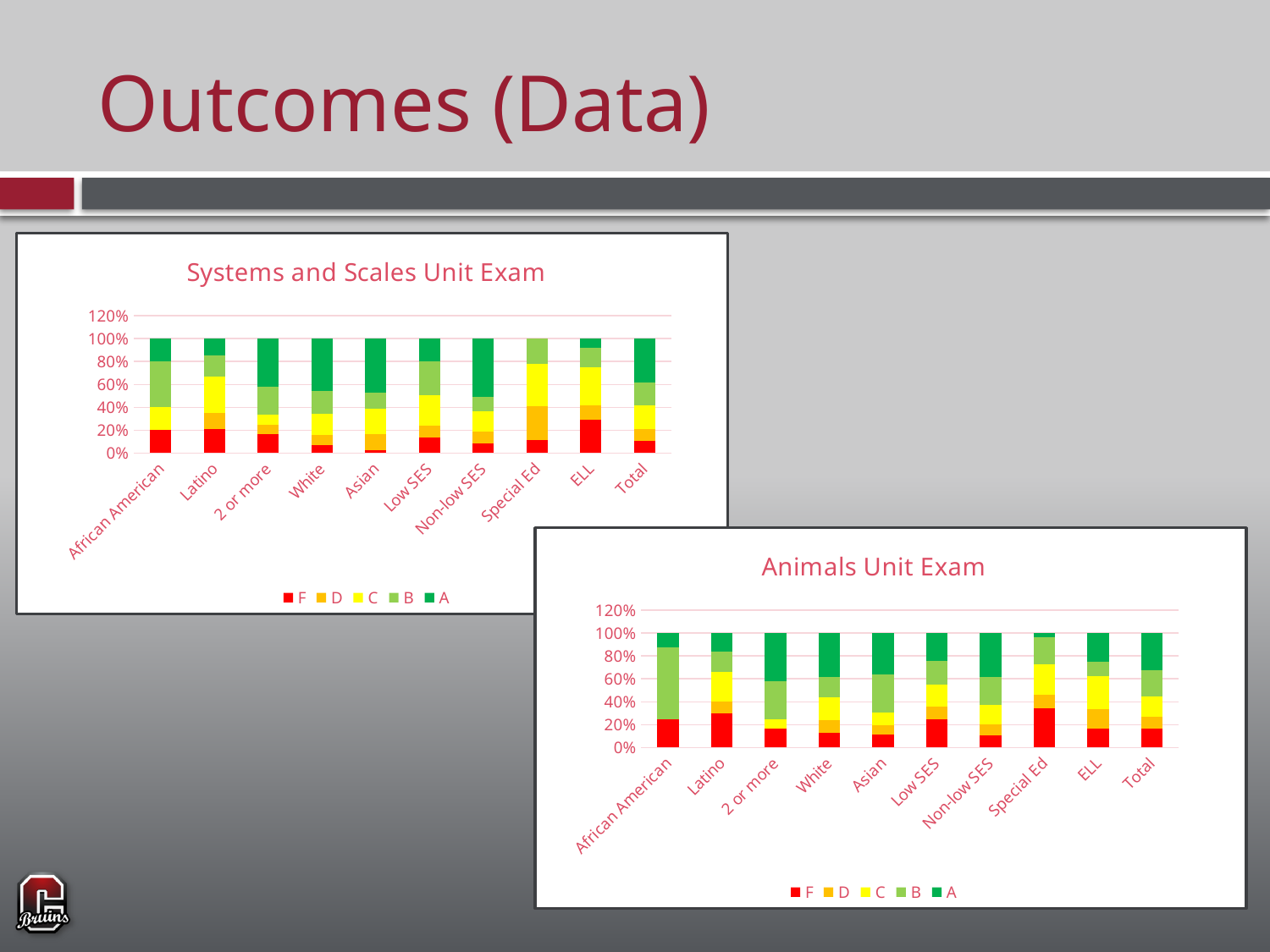
In the Systems and Scales Unit Exam chart, which category has the largest F share? ELL What type of chart is the Systems and Scales Unit Exam chart? Stacked bar chart In the Systems and Scales Unit Exam chart, is the F share for Asian greater or less than 20%? less In the Animals Unit Exam chart, is the F share for Latino larger or smaller than the F share for White? larger What are the legend entries in the Animals Unit Exam chart? F, D, C, B, A In the Animals Unit Exam chart, is the F share for Non-low SES greater or less than 20%? less In the Animals Unit Exam chart, is the F share for Special Ed greater or less than 20%? greater What is the title of the chart in the lower right of the slide? Animals Unit Exam How many categories are shown on the x axis of the Animals Unit Exam chart? 10 In the Animals Unit Exam chart, which category has the smallest A share? Special Ed How many series does the legend of the Systems and Scales Unit Exam chart list? 5